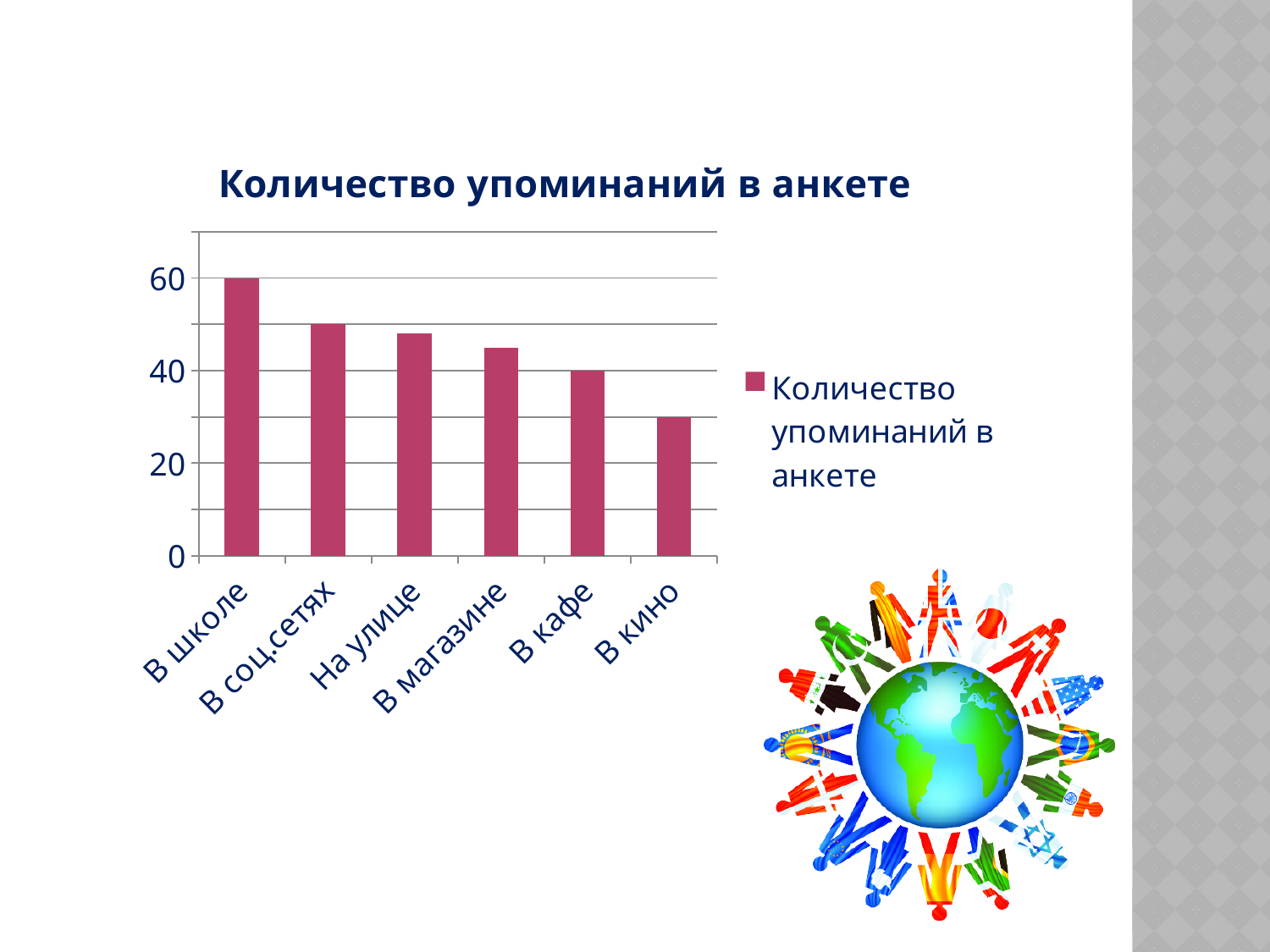
Do the values rise or fall from left to right along the x axis? Fall How many series does the legend list? 1 What is the difference between the values for В школе and В кафе? 20 Which category has the highest value? В школе Which category has the lowest value? В кино What type of chart is shown on the slide? Bar chart How many categories are shown on the x axis of the chart? 6 What is the title of the chart? Количество упоминаний в анкете Is the value for В кино greater or less than 40? less What is the value for В школе? 60 What is the value for В кафе? 40 Is the value for В соц.сетях greater or less than 40? greater